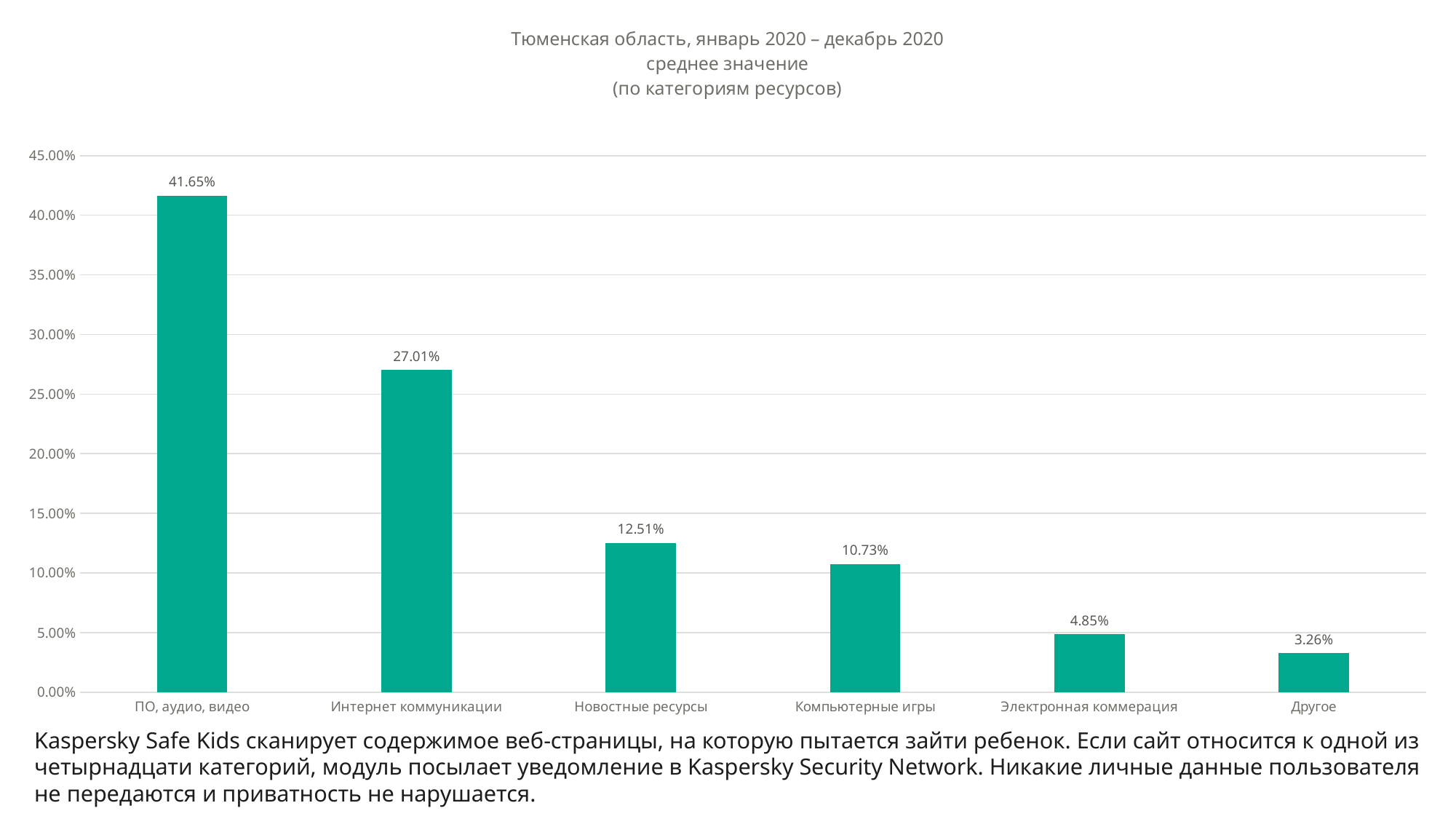
Which is larger, the value for Новостные ресурсы or the value for Компьютерные игры? Новостные ресурсы Which category has the highest value? ПО, аудио, видео What is the value for Электронная коммерация? 4.85% What is the value for Новостные ресурсы? 12.51% What is the value for ПО, аудио, видео? 41.65% Which category has the lowest value? Другое What is the value for Интернет коммуникации? 27.01% How many categories are shown on the chart? 6 Is the value for Компьютерные игры greater or less than 10.00%? greater Do the values rise or fall from left to right along the x axis? fall What is the difference between the values for ПО, аудио, видео and Интернет коммуникации? 14.64% What kind of chart is shown on the slide? bar chart